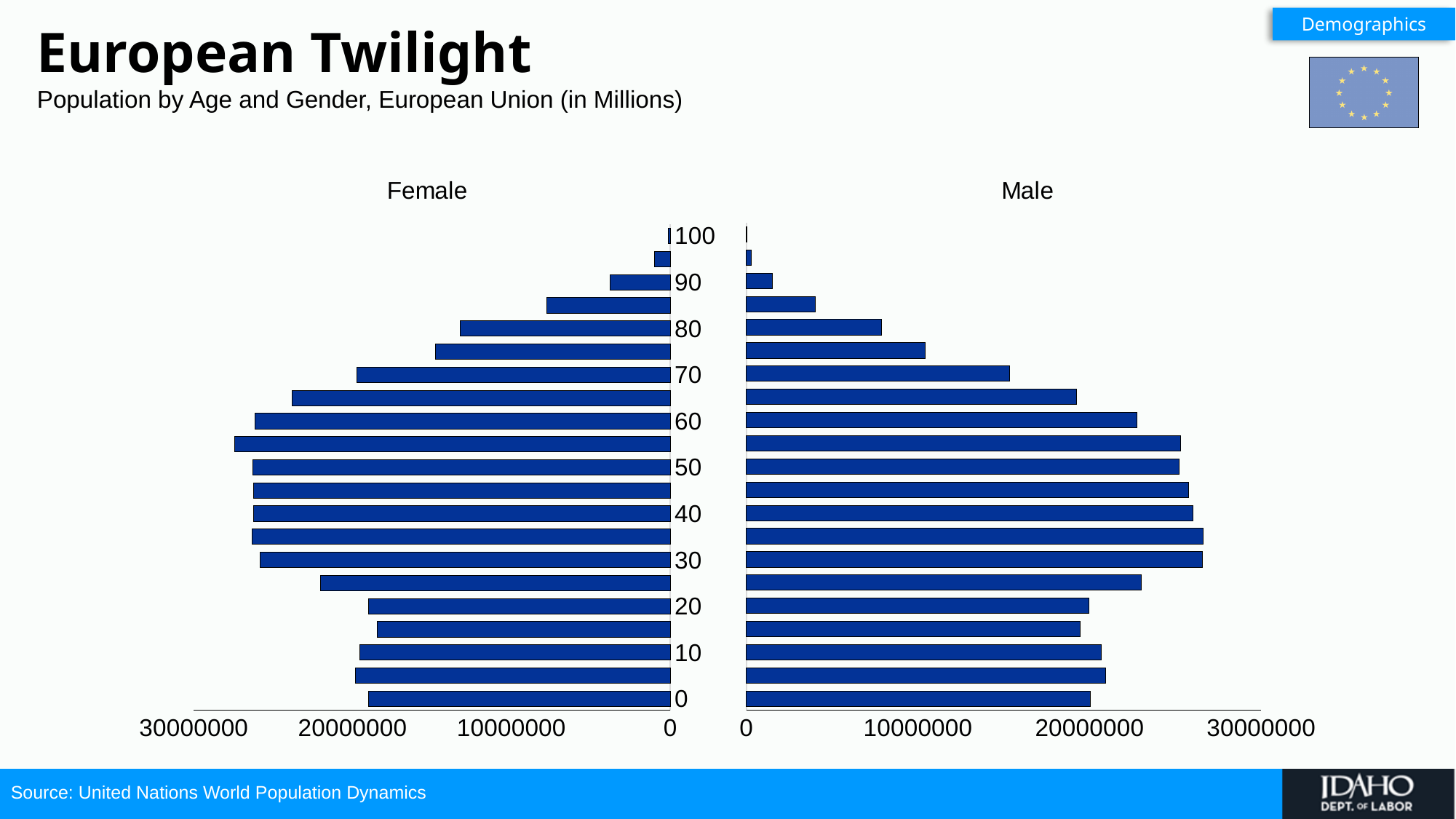
How many bars are plotted in the Male chart? 21 In the Female chart, is the value for age 60 greater or less than 20000000? greater What kind of chart is shown on the slide? bar chart In the Male chart, which age group has the shortest bar? 100 What is the subtitle describing the data on the slide? Population by Age and Gender, European Union (in Millions) In the Male chart, is the value for age 40 greater or less than 20000000? greater In the Male chart, is the value for age 70 greater or less than 10000000? greater In the Female chart, do the values rise or fall as age increases from 60 to 100? fall In the Female chart, which age group has the longest bar? 55 In the Female chart, which age group has the shortest bar? 100